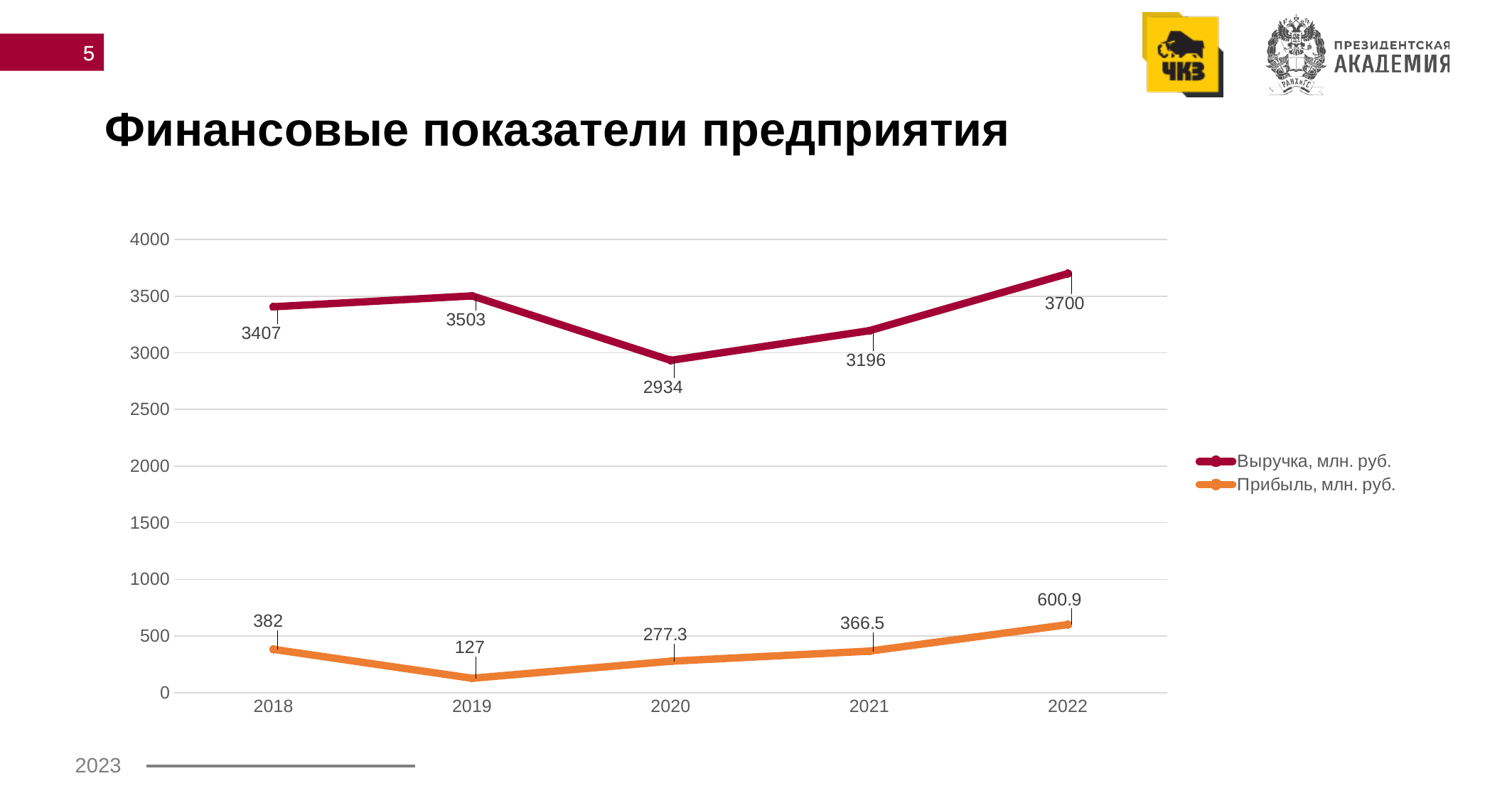
Is the value of Выручка, млн. руб. in 2019 greater or less than 3000? greater What is the value of Выручка, млн. руб. in 2020? 2934 In which year is Выручка, млн. руб. highest? 2022 What is the difference between Выручка, млн. руб. in 2022 and in 2021? 504 What type of chart is shown on the slide? line chart What is the value of Прибыль, млн. руб. in 2019? 127 Does Прибыль, млн. руб. rise or fall from 2019 to 2022? rise Which is larger: Прибыль, млн. руб. in 2018 or in 2021? 2018 What is the value of Прибыль, млн. руб. in 2022? 600.9 How many years are shown on the x axis? 5 How many series does the legend list? 2 In which year is Прибыль, млн. руб. lowest? 2019